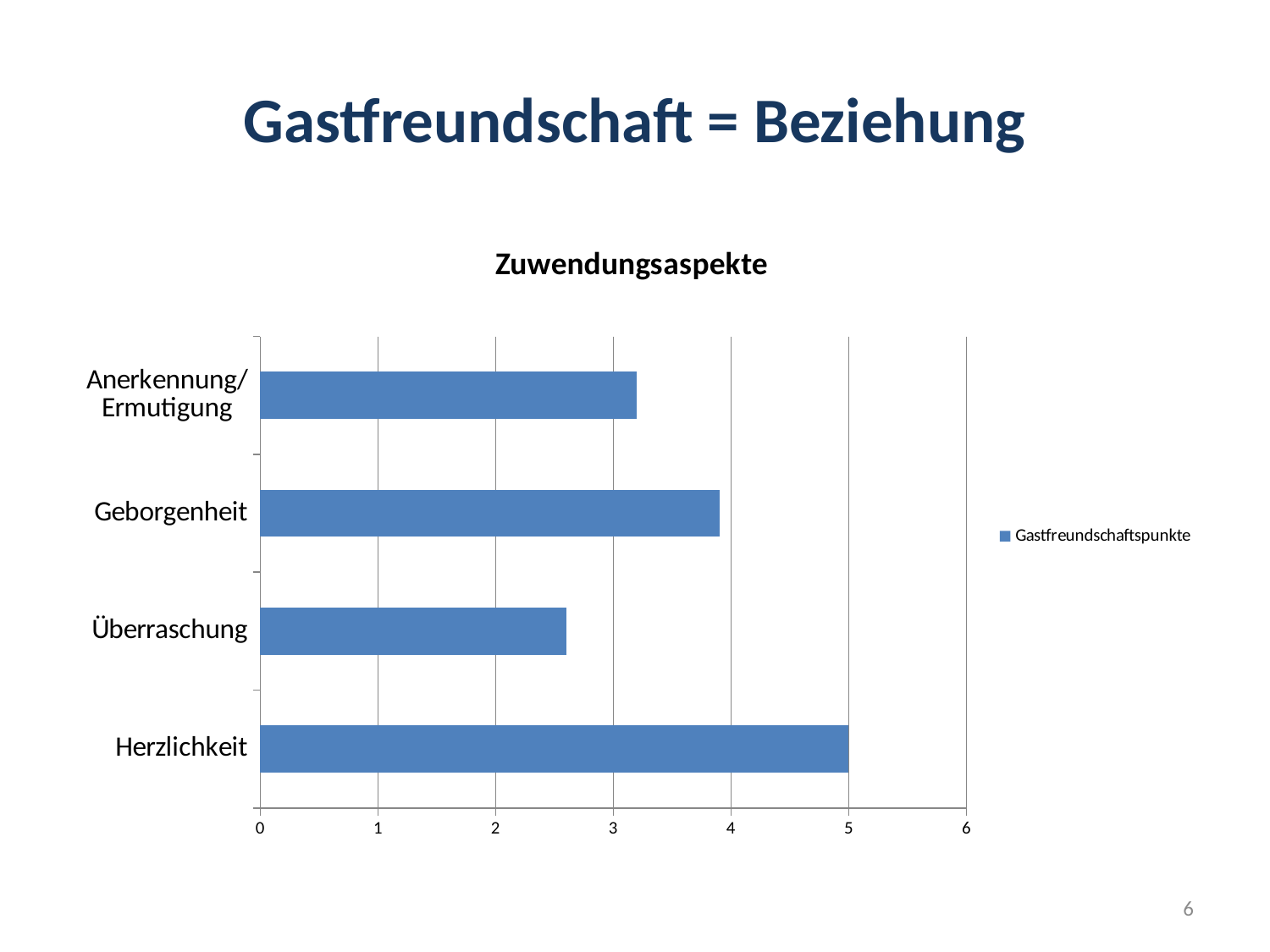
How many categories are shown in the chart? 4 What is the value for Herzlichkeit? 5 What is the title of the chart? Zuwendungsaspekte Is the value for Anerkennung/Ermutigung greater or less than 4? less Is the value for Geborgenheit greater or less than 3? greater Is the value for Überraschung greater or less than 3? less What series name does the legend list? Gastfreundschaftspunkte Which category has the lowest value? Überraschung Which is larger, the value for Geborgenheit or the value for Anerkennung/Ermutigung? Geborgenheit What kind of chart is shown on the slide? bar chart Which category has the highest value? Herzlichkeit How many series does the legend list? 1